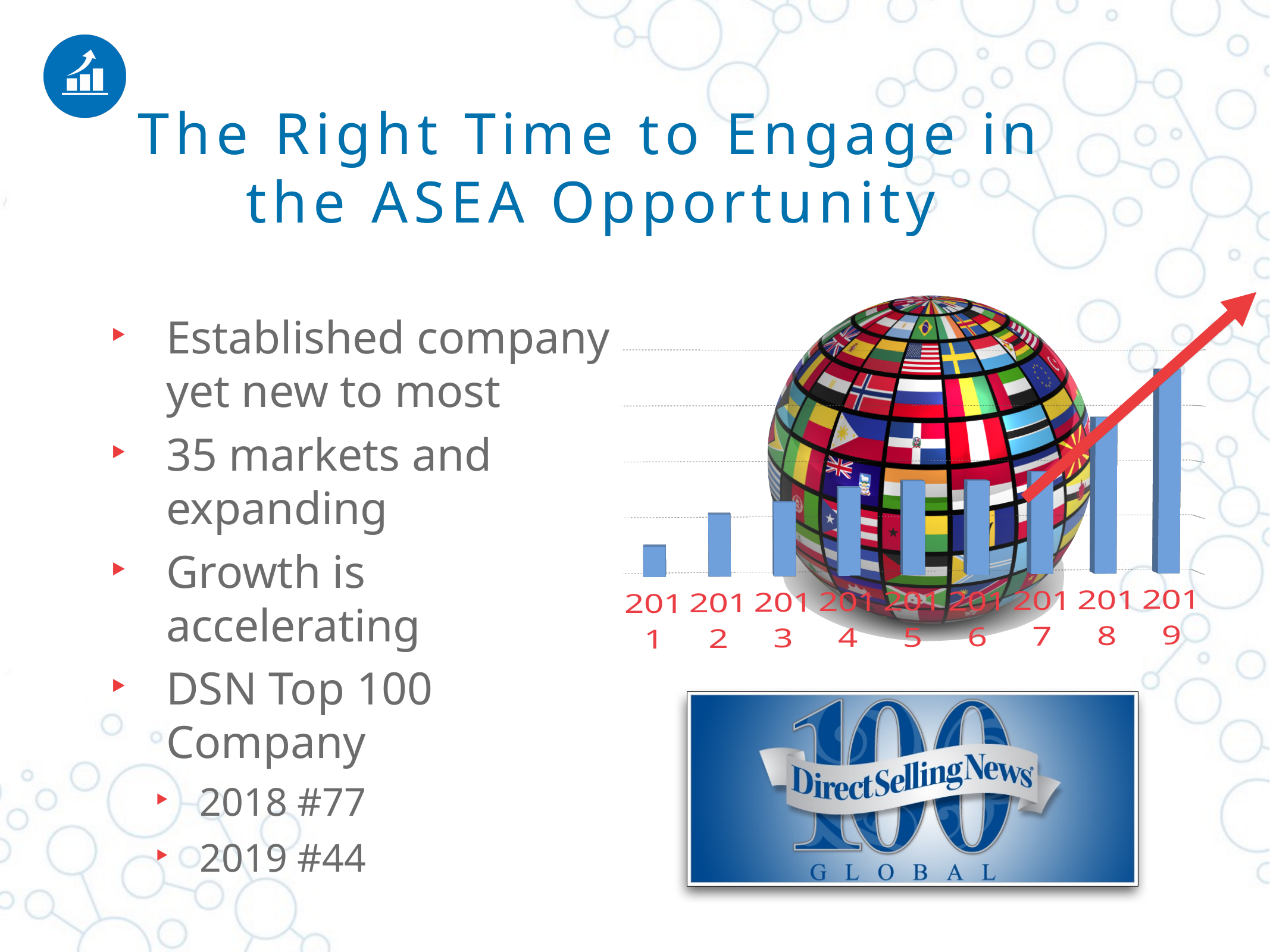
Which bar is taller, 2011 or 2019? 2019 What is the first year shown on the chart's x axis? 2011 Which year has the shortest bar in the chart? 2011 How many years are shown on the x axis of the chart? 9 What kind of chart is shown on the slide? bar chart Which bar is taller, 2012 or 2018? 2018 Which year has the tallest bar in the chart? 2019 Which bar is taller, 2011 or 2013? 2013 What colour are the bars in the chart? blue Do the bar values generally rise or fall from 2011 to 2019? rise